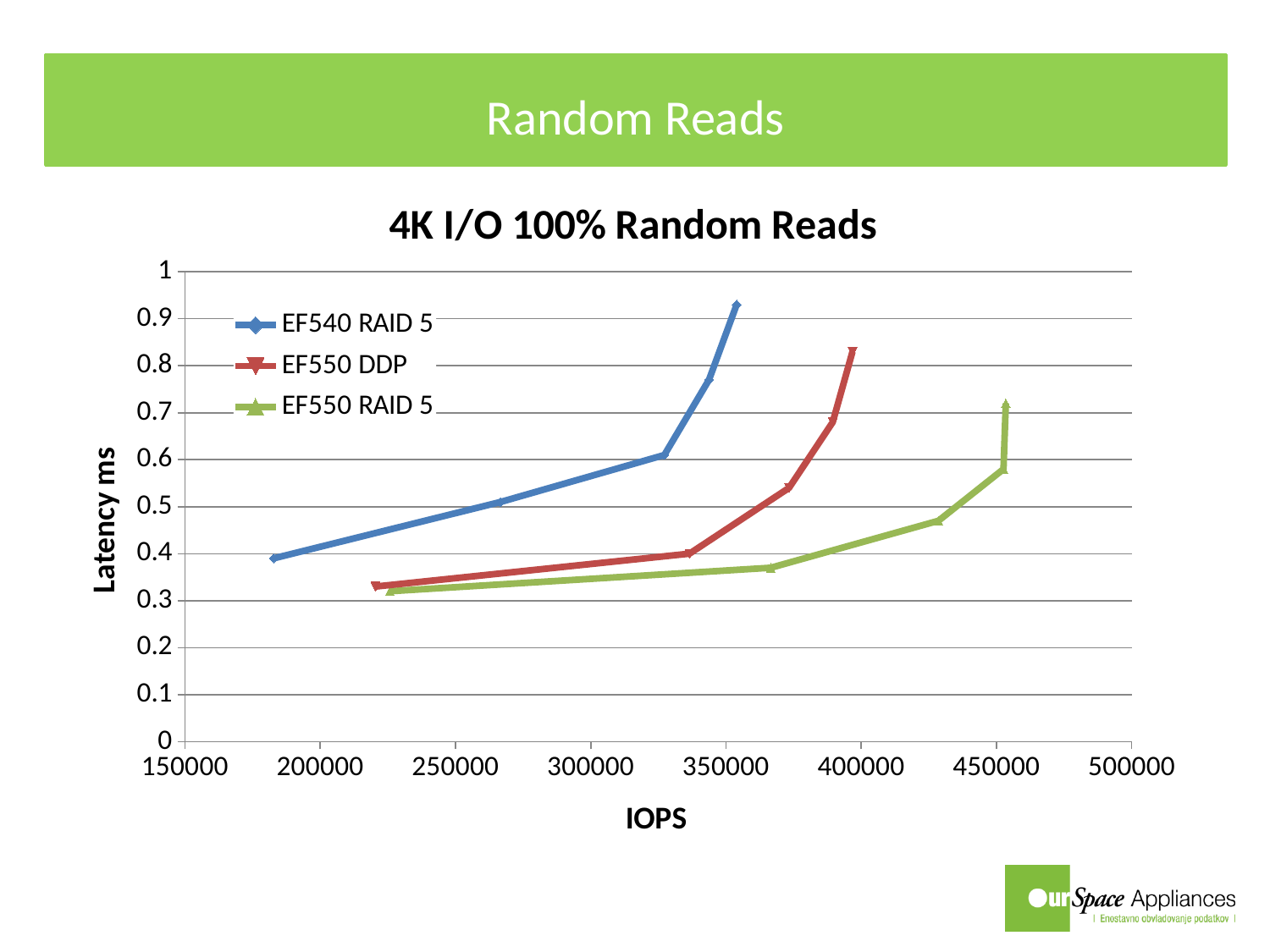
Is the lowest latency of EF550 RAID 5 greater or less than 0.4? less Is the highest IOPS reached by EF540 RAID 5 greater or less than 400000? less Is the highest IOPS reached by EF550 RAID 5 greater or less than 400000? greater Does latency rise or fall as IOPS increases for each series? rise Which series reaches the highest latency value on the chart? EF540 RAID 5 What kind of chart is shown on the slide? line chart Which series reaches the highest IOPS value on the chart? EF550 RAID 5 What is the title of the chart? 4K I/O 100% Random Reads Which series reaches higher IOPS, EF550 DDP or EF540 RAID 5? EF550 DDP What is the label of the vertical axis? Latency ms How many series does the legend list? 3